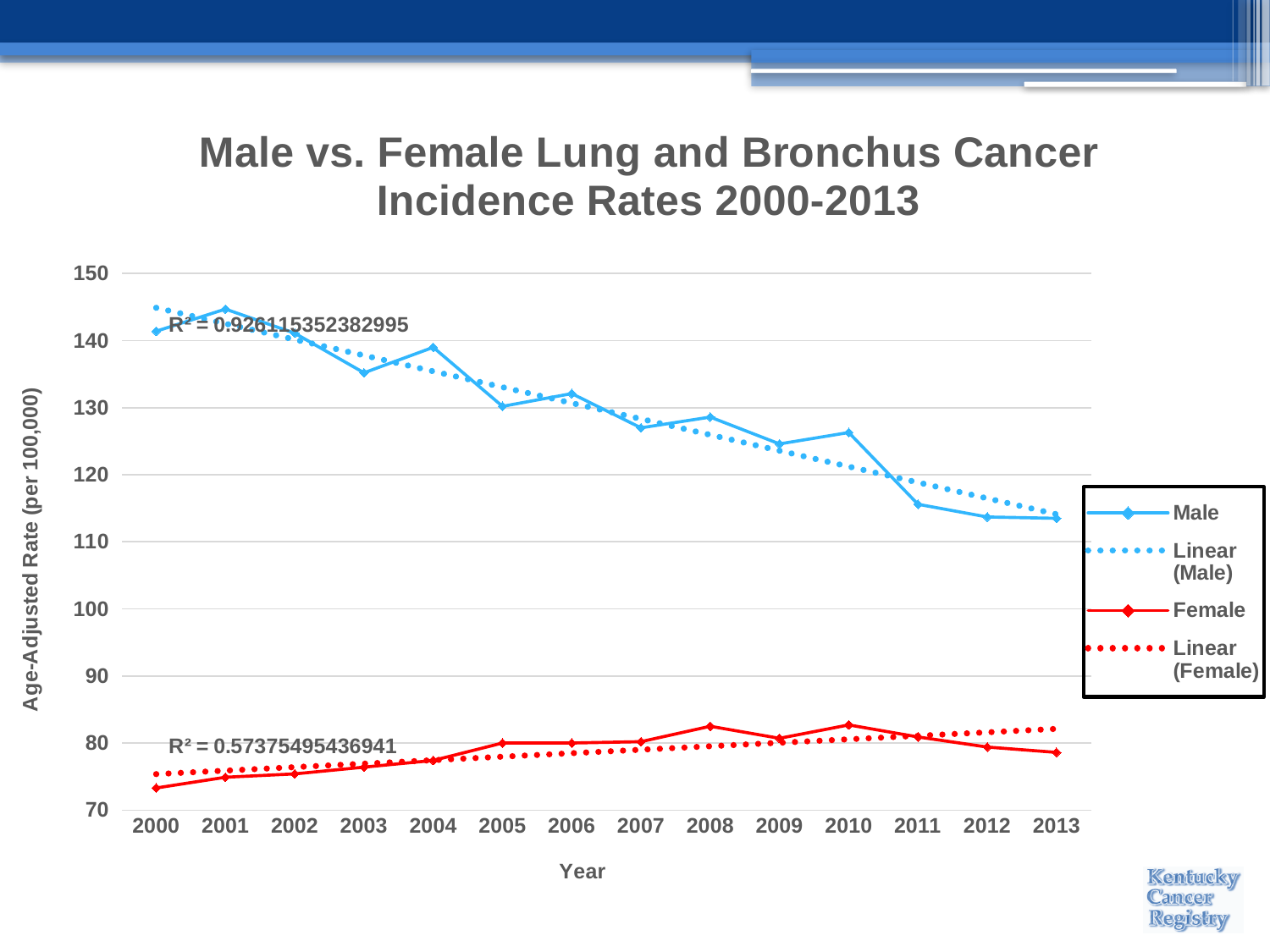
In which year is the Female incidence rate lowest? 2000 How many years are plotted along the x axis? 14 What kind of chart is shown on the slide? Line chart Does the Female incidence rate rise or fall from 2000 to 2013? Rise Does the Male incidence rate rise or fall from 2000 to 2013? Fall In which year is the Male incidence rate highest? 2001 Is the Male value for 2003 greater or less than 130? greater Is the Female value for 2008 greater or less than 80? greater What R² value is shown for the Male linear trendline? R² = 0.926115352382995 How many entries does the legend list? 4 Which series has the higher incidence rate in 2013, Male or Female? Male Is the Male value for 2011 greater or less than 120? less